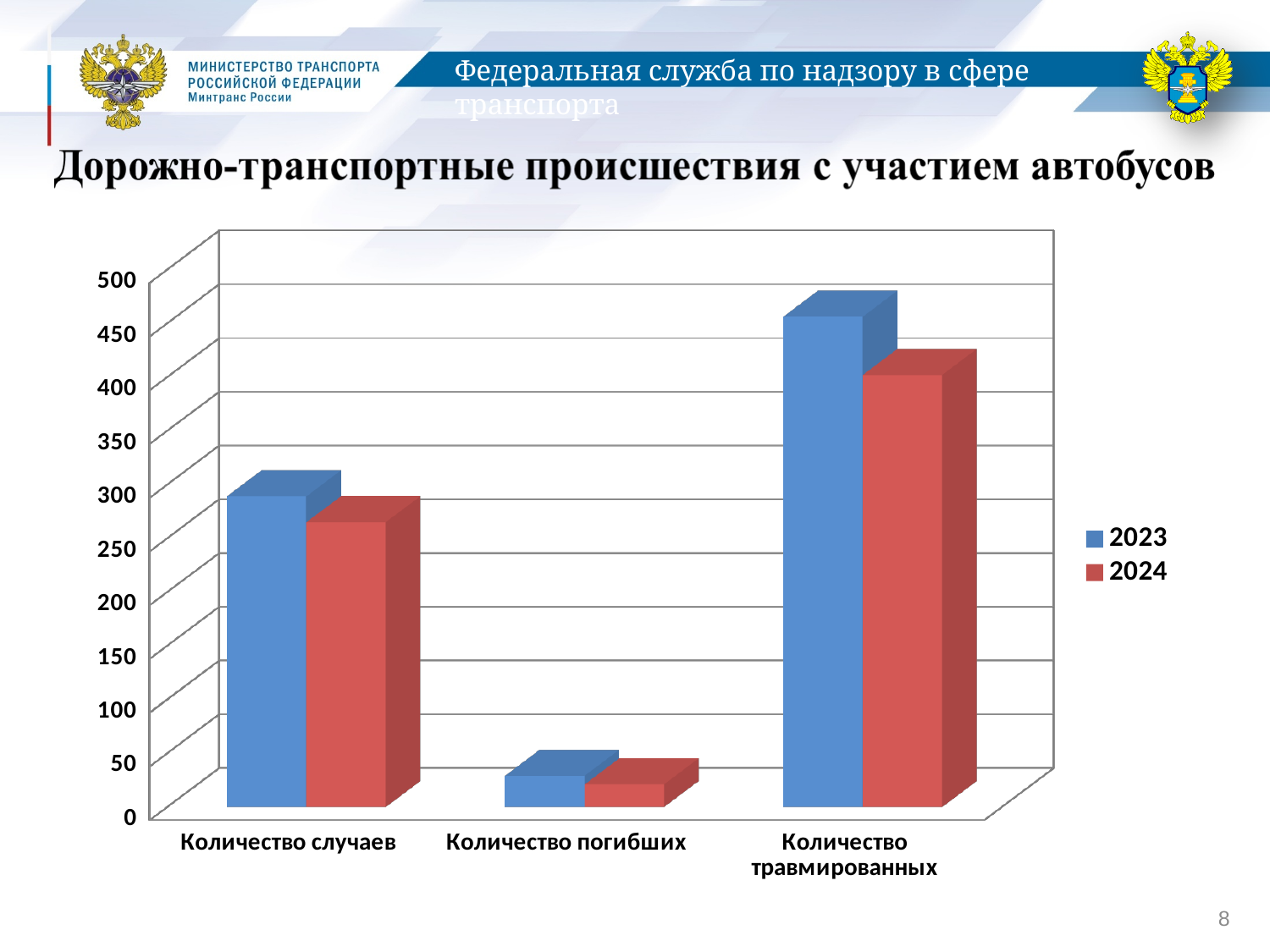
How many categories are shown on the x axis? 3 Is the value for Количество погибших in 2023 greater or less than 50? less How many series does the legend list? 2 What kind of chart is shown on the slide? Bar chart Which category has the highest bar for 2023? Количество травмированных For Количество случаев, which year has the larger value, 2023 or 2024? 2023 Which category has the lowest bar for 2024? Количество погибших Is the value for Количество случаев in 2024 greater or less than 300? less For Количество травмированных, which year has the larger value, 2023 or 2024? 2023 Which colour represents the 2024 series in the legend? Red Is the value for Количество травмированных in 2023 greater or less than 400? greater